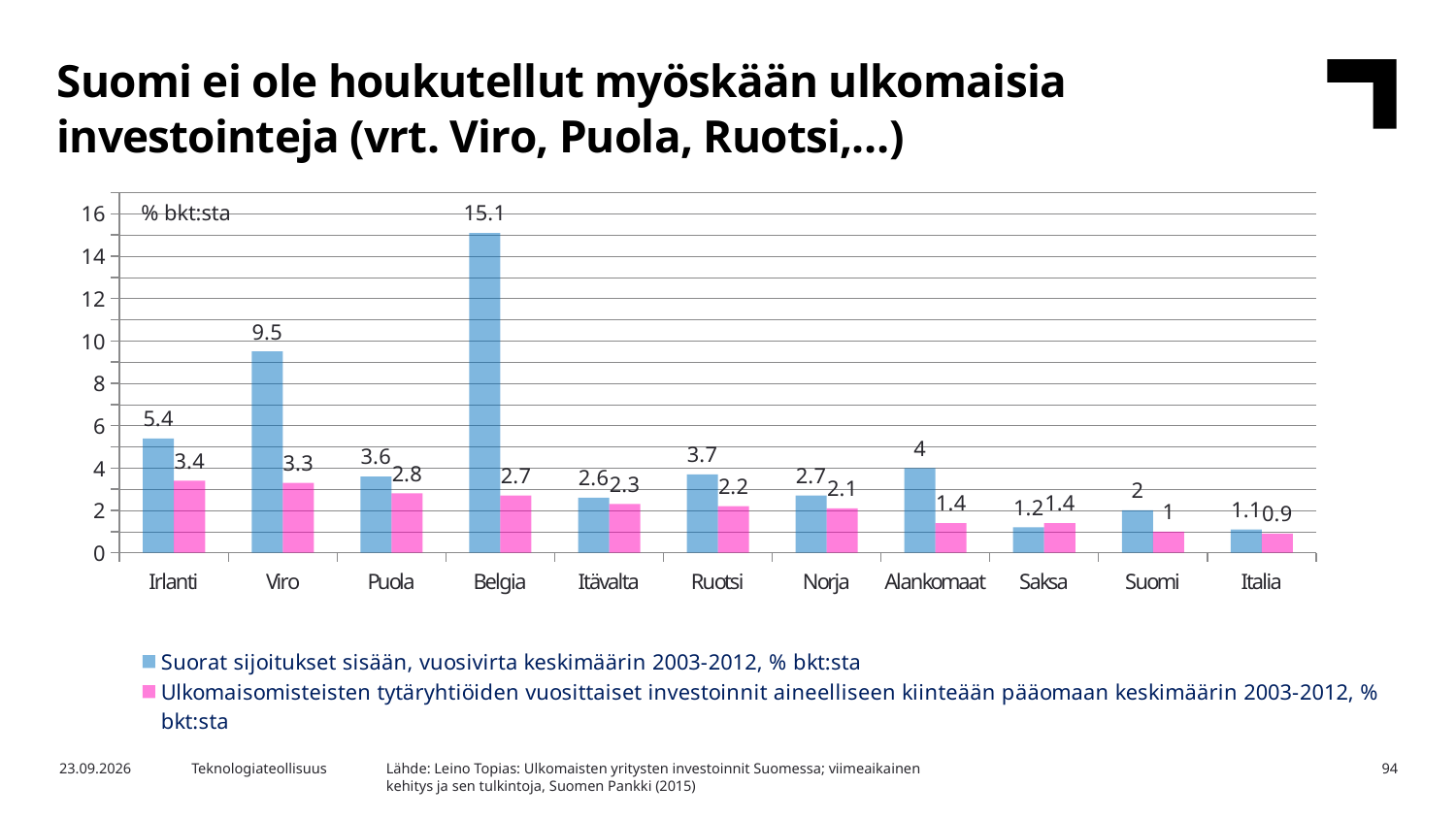
What is the difference between the blue series values for Belgia and Viro? 5.6 What unit label is shown at the top left of the chart's plot area? % bkt:sta Is the blue series value for Viro greater or less than 8? greater Which country has the highest value in the blue series (Suorat sijoitukset sisään)? Belgia Which is larger: the blue series value for Irlanti or the blue series value for Alankomaat? Irlanti What is the value of the blue series (Suorat sijoitukset sisään) for Belgia? 15.1 What is the value of the pink series (Ulkomaisomisteisten tytäryhtiöiden investoinnit) for Suomi? 1 What is the value of the blue series (Suorat sijoitukset sisään) for Viro? 9.5 How many countries are shown on the x axis of the chart? 11 What type of chart is shown on the slide? Bar chart Which country has the lowest value in the pink series (Ulkomaisomisteisten tytäryhtiöiden investoinnit)? Italia How many series does the chart legend list? 2